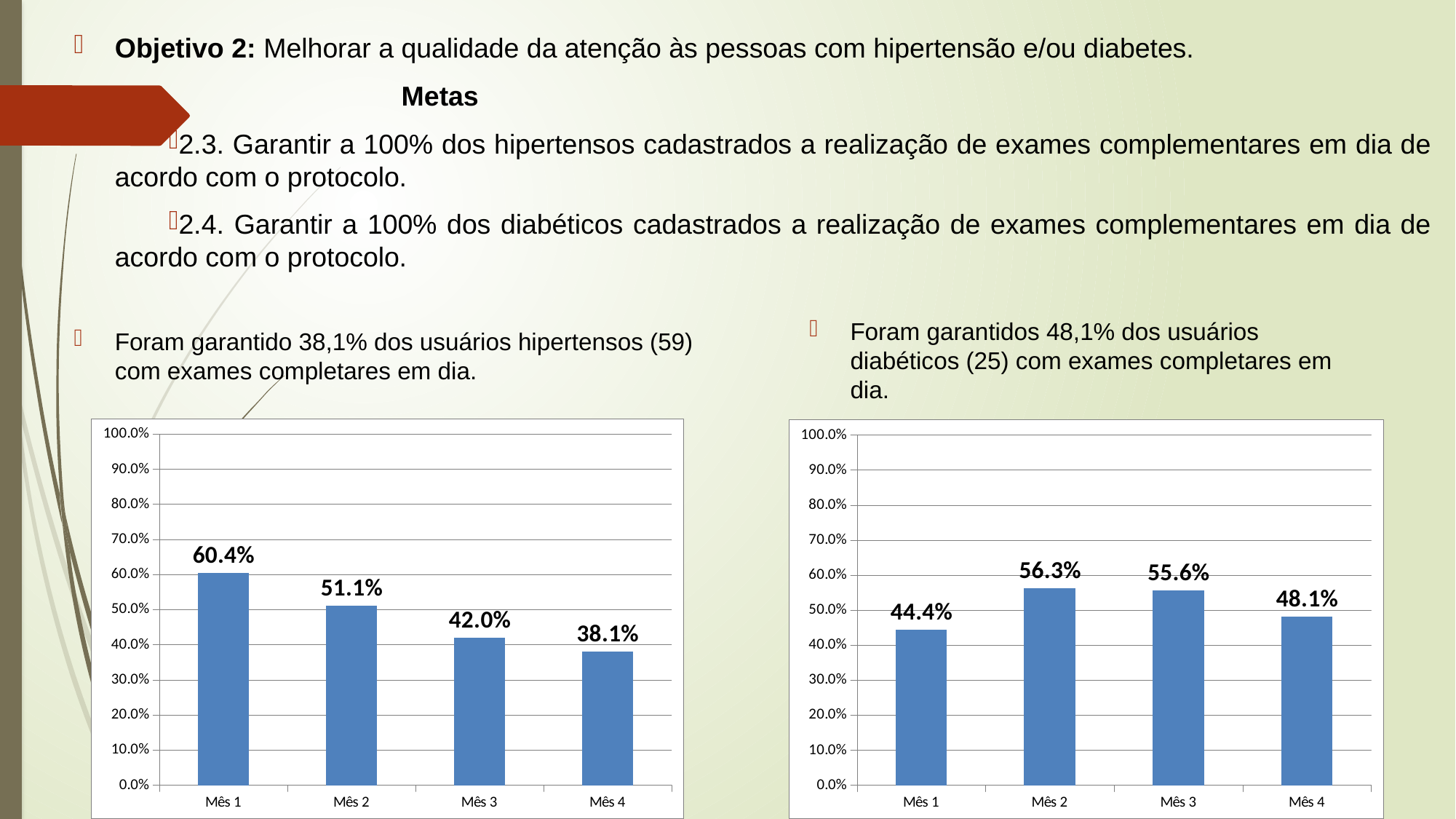
In the right chart, what is the value for Mês 2? 56.3% In the right chart, what is the difference between the values for Mês 3 and Mês 1? 11.2% In the left chart, what is the difference between the values for Mês 1 and Mês 4? 22.3% In the right chart, what is the value for Mês 4? 48.1% In the right chart, which is larger, the value for Mês 2 or the value for Mês 1? Mês 2 How many bars does the left chart have? 4 In the left chart, do the values rise or fall from Mês 1 to Mês 4? fall What kind of chart is the right chart? bar chart In the left chart, which month has the highest value? Mês 1 In the right chart, which month has the lowest value? Mês 1 In the left chart, what is the value for Mês 4? 38.1% In the left chart, what is the value for Mês 1? 60.4%